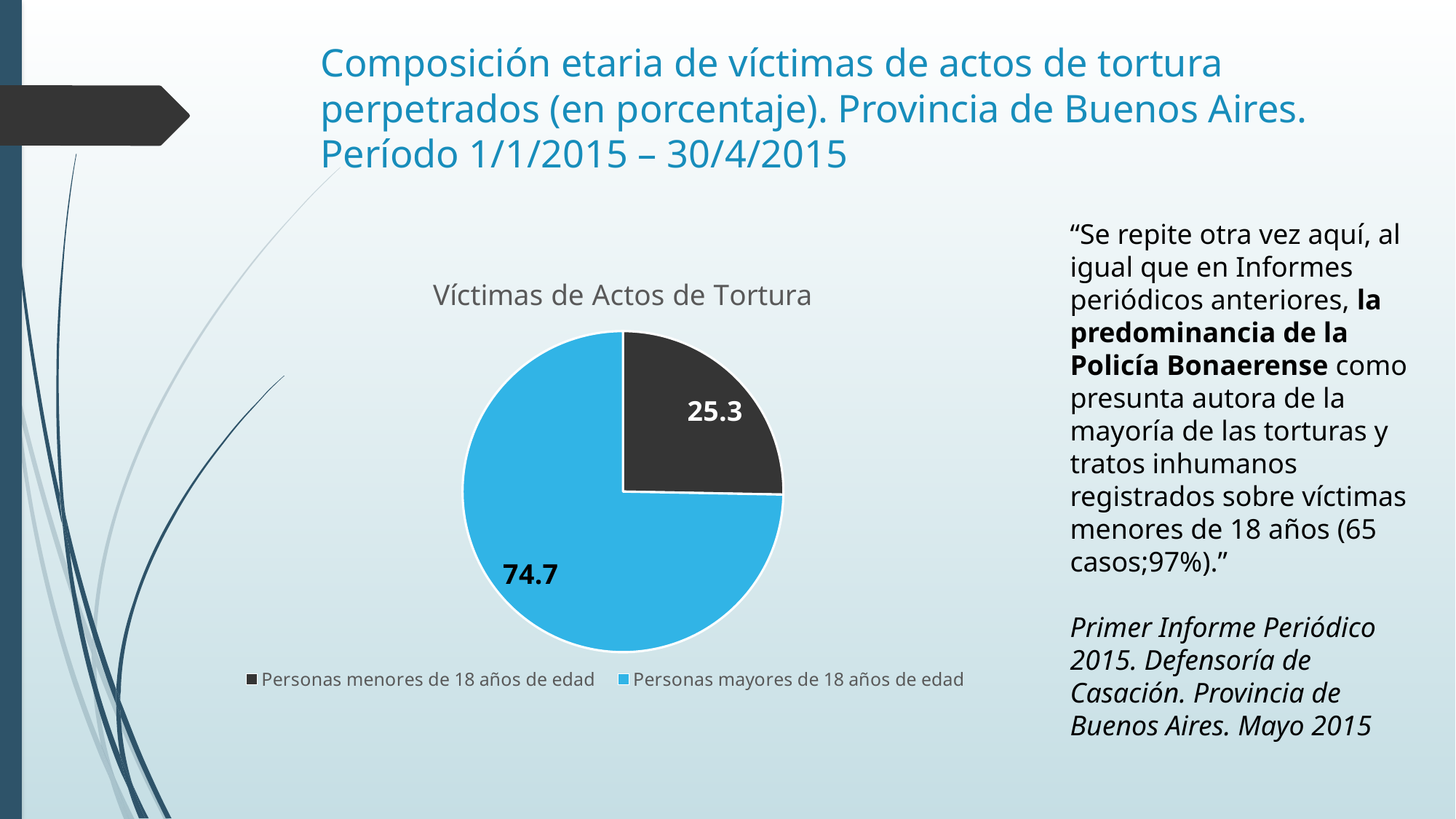
Which category has the smallest slice? Personas menores de 18 años de edad What is the value for Personas mayores de 18 años de edad? 74.7 What colour is the slice for Personas mayores de 18 años de edad? blue Which is larger, the slice for Personas menores de 18 años de edad or the slice for Personas mayores de 18 años de edad? Personas mayores de 18 años de edad Which category has the largest slice? Personas mayores de 18 años de edad How many slices does the pie chart have? 2 What is the chart's title? Víctimas de Actos de Tortura What kind of chart is shown on the slide? pie chart How many entries does the legend list? 2 What is the difference between the values for Personas mayores de 18 años de edad and Personas menores de 18 años de edad? 49.4 What is the value for Personas menores de 18 años de edad? 25.3 What is the total of the two slice values shown? 100